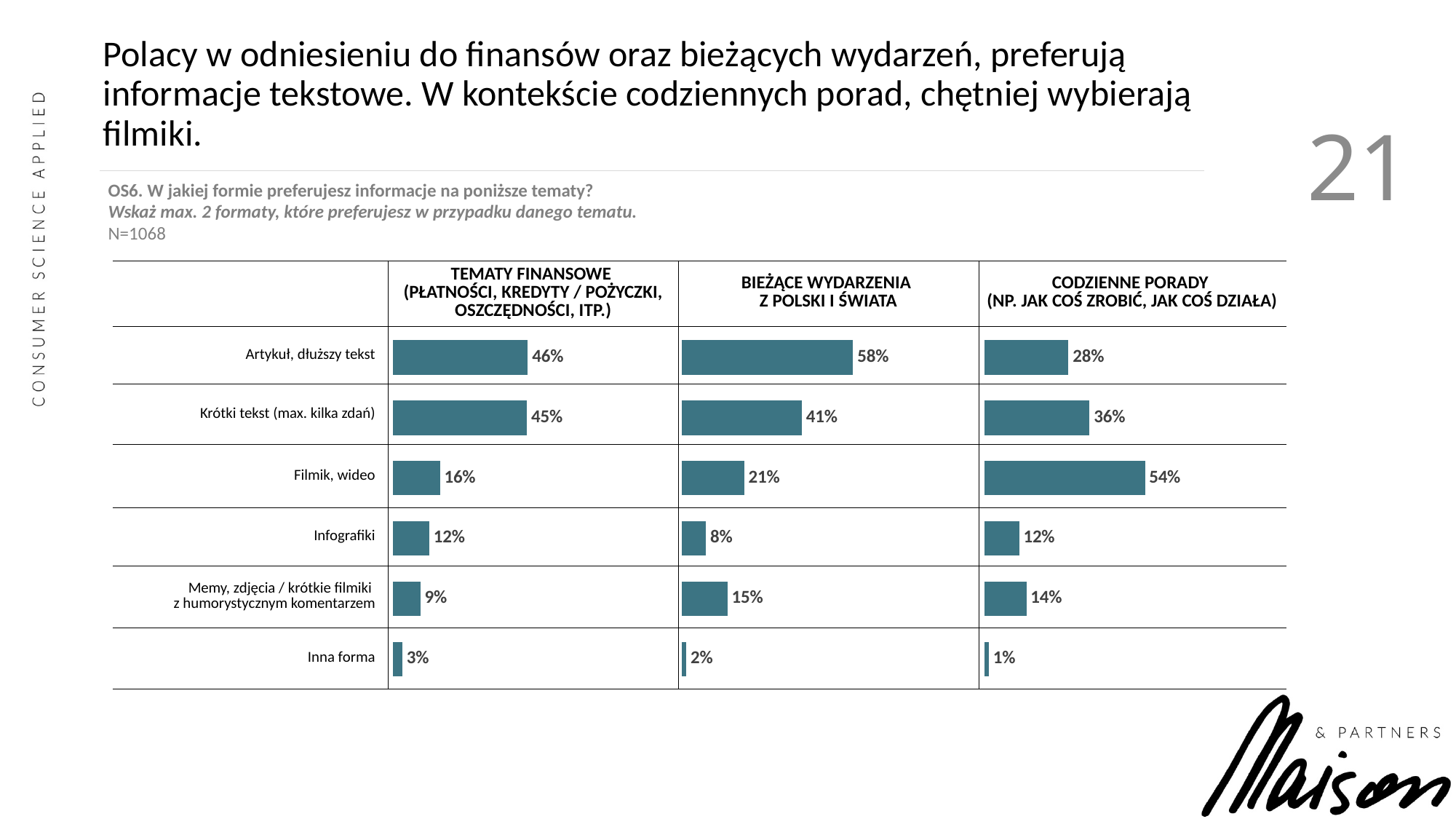
How many categories are shown in each chart? 6 In the CODZIENNE PORADY chart, what is the value for Krótki tekst (max. kilka zdań)? 36% In the BIEŻĄCE WYDARZENIA Z POLSKI I ŚWIATA chart, which category has the lowest value? Inna forma In the BIEŻĄCE WYDARZENIA Z POLSKI I ŚWIATA chart, what is the value for Filmik, wideo? 21% In the TEMATY FINANSOWE chart, what is the value for Artykuł, dłuższy tekst? 46% In the CODZIENNE PORADY chart, which category has the highest value? Filmik, wideo What is the sample size (N) stated on the slide? N=1068 In the TEMATY FINANSOWE chart, what is the value for Inna forma? 3% What kind of chart is used on this slide? Bar chart In the BIEŻĄCE WYDARZENIA Z POLSKI I ŚWIATA chart, which is larger: Infografiki or Memy, zdjęcia / krótkie filmiki z humorystycznym komentarzem? Memy, zdjęcia / krótkie filmiki z humorystycznym komentarzem In the CODZIENNE PORADY chart, what is the difference between Filmik, wideo and Artykuł, dłuższy tekst? 26 percentage points In the TEMATY FINANSOWE chart, what is the difference between Artykuł, dłuższy tekst and Filmik, wideo? 30 percentage points